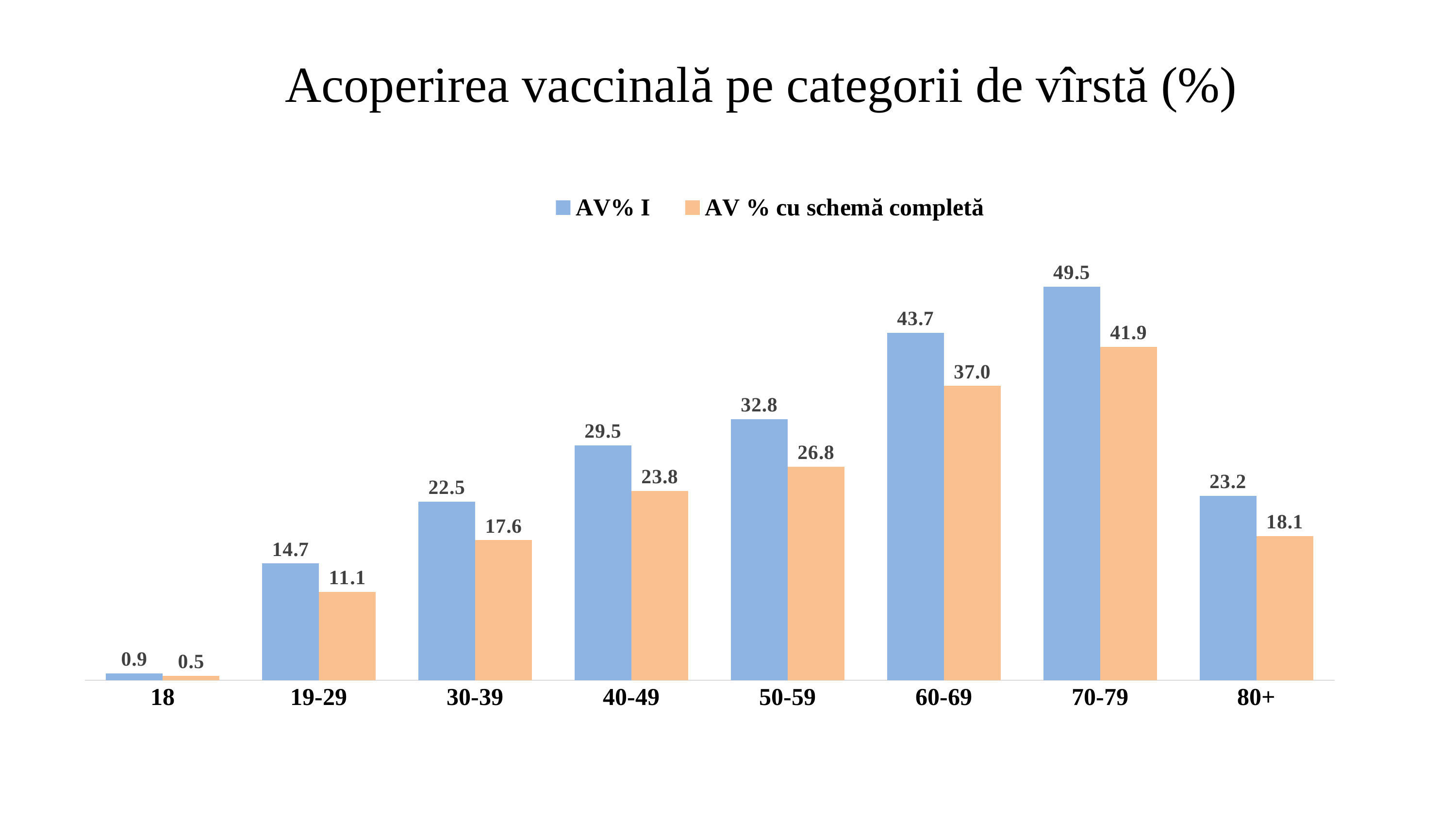
What is the difference between the AV% I values for the 60-69 and 50-59 age groups? 10.9 What is the AV % cu schemă completă value for the 80+ age group? 18.1 What is the AV% I value for the 40-49 age group? 29.5 What is the AV % cu schemă completă value for the 60-69 age group? 37.0 Which age group has the highest AV% I value? 70-79 What kind of chart is shown on the slide? Bar chart Which is larger: the AV% I value for 30-39 or the AV % cu schemă completă value for 40-49? AV % cu schemă completă for 40-49 How many series does the legend list? 2 What is the difference between AV% I and AV % cu schemă completă for the 70-79 age group? 7.6 What is the title of the chart? Acoperirea vaccinală pe categorii de vîrstă (%) Which age group has the lowest AV % cu schemă completă value? 18 How many age groups are shown on the x axis? 8